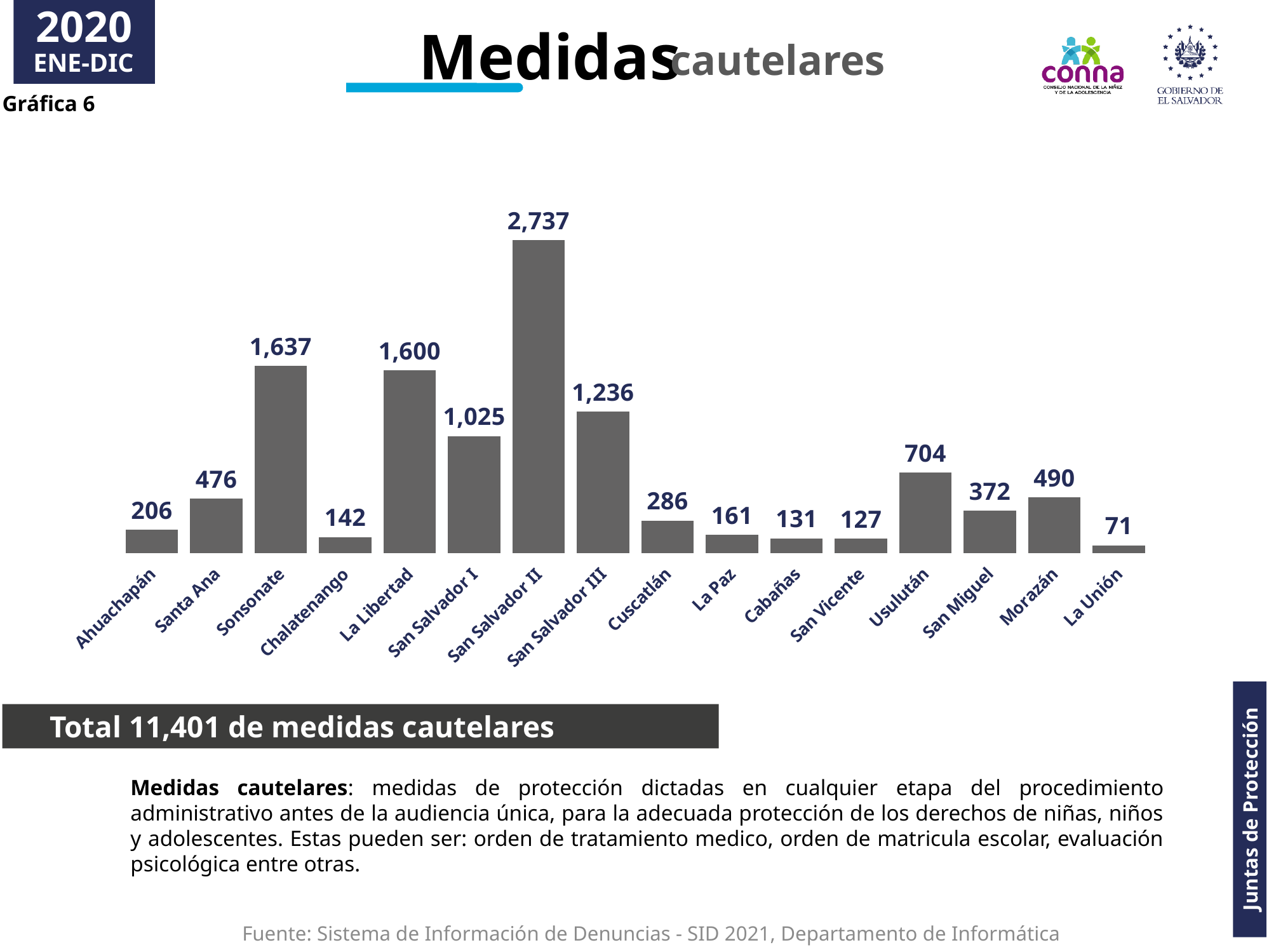
What is the value for Usulután? 704 Which is larger, the value for Morazán or the value for Santa Ana? Morazán What total is stated in the banner below the chart? 11,401 What kind of chart is shown on the slide? Bar chart Which category has the highest value? San Salvador II Which is larger, the value for Cuscatlán or the value for San Miguel? San Miguel What is the difference between the values for San Salvador II and San Salvador III? 1,501 How many categories are shown on the x axis? 16 Which category has the lowest value? La Unión What is the value for San Salvador II? 2,737 What is the value for Chalatenango? 142 What is the difference between the values for Sonsonate and La Libertad? 37